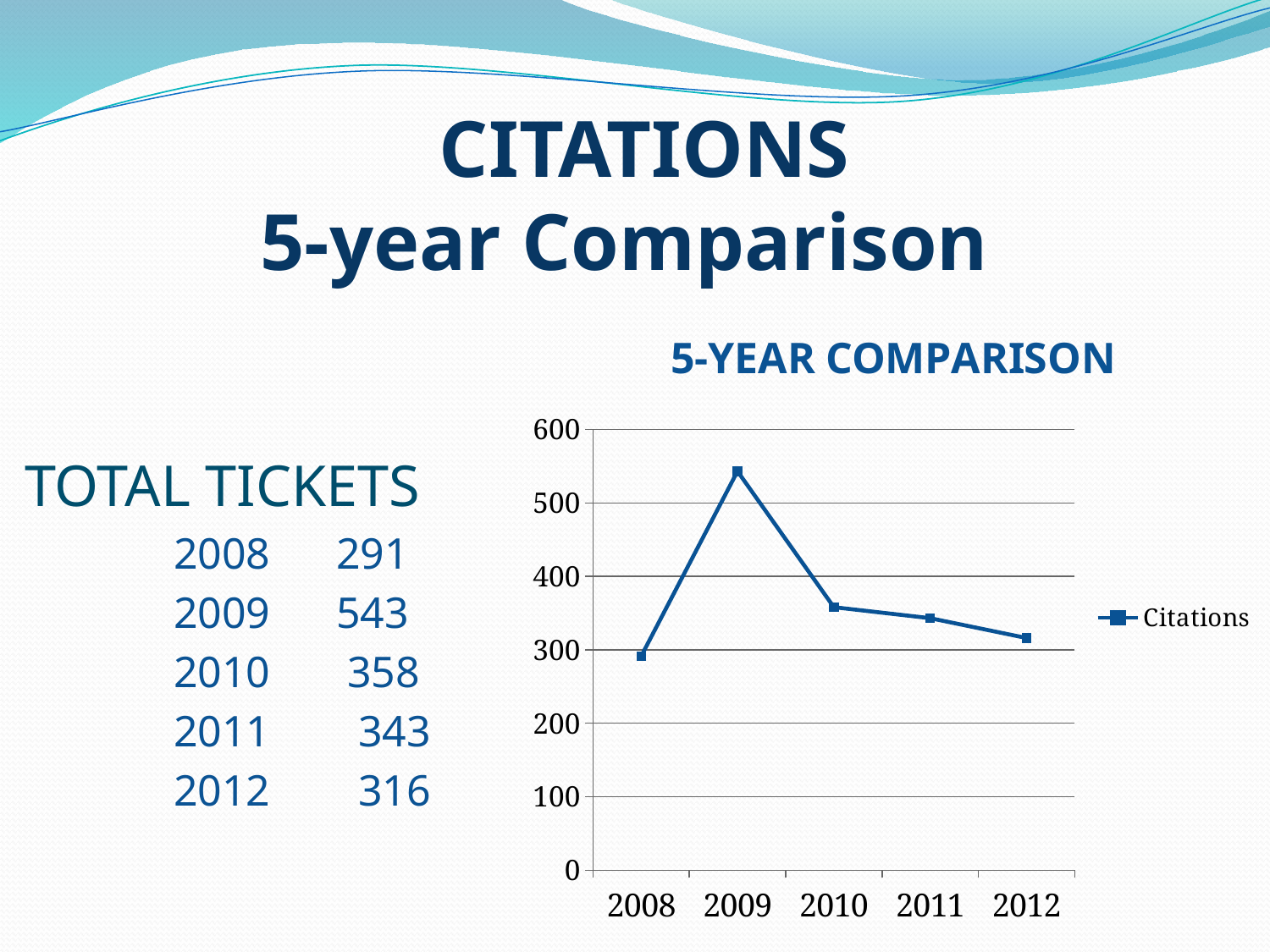
What is the number of citations for 2009? 543 Is the value for 2009 greater or less than 500? greater Which year has the lowest number of citations? 2008 What is the difference in citations between 2009 and 2010? 185 Do the citations rise or fall from 2010 to 2012? fall What is the title of the chart? 5-YEAR COMPARISON Which year has the highest number of citations? 2009 What is the name of the series shown in the legend? Citations What kind of chart is shown on the slide? line chart What is the number of citations for 2012? 316 How many series does the chart legend list? 1 How many years are plotted on the x axis of the chart? 5